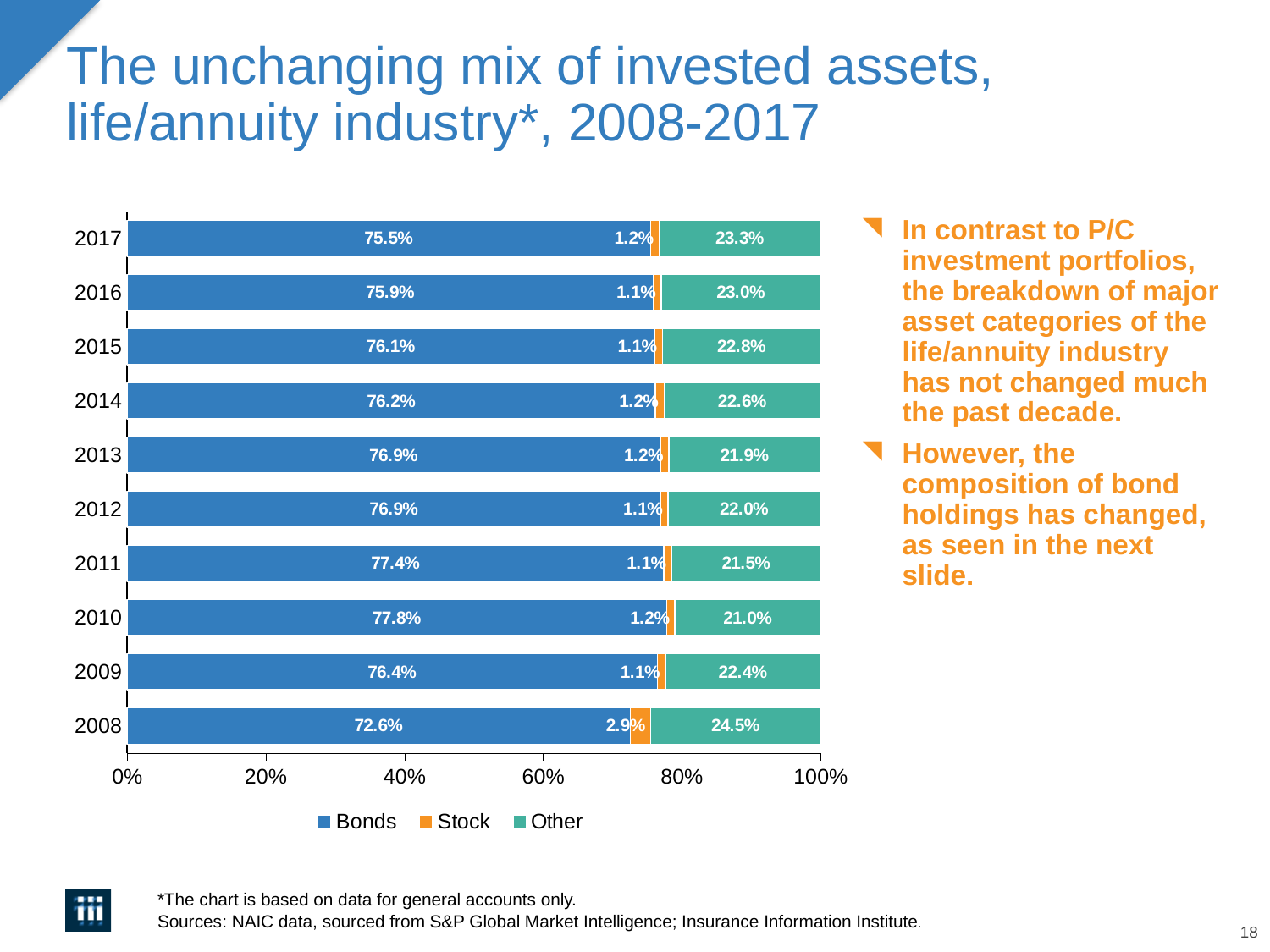
In which year was the Bonds share highest? 2010 What share of invested assets was in Bonds in 2017? 75.5% How many percentage points higher was the Bonds share in 2017 than in 2008? 2.9 percentage points How many years are shown on the chart? 10 From 2010 to 2017, does the Bonds share rise or fall? Fall Which year had a larger Other share, 2017 or 2010? 2017 How many series does the legend list? 3 What was the Other share in 2013? 21.9% What was the Stock share in 2008? 2.9% In which year was the Bonds share lowest? 2008 In which year was the Other share highest? 2008 What type of chart is shown on the slide? Stacked bar chart